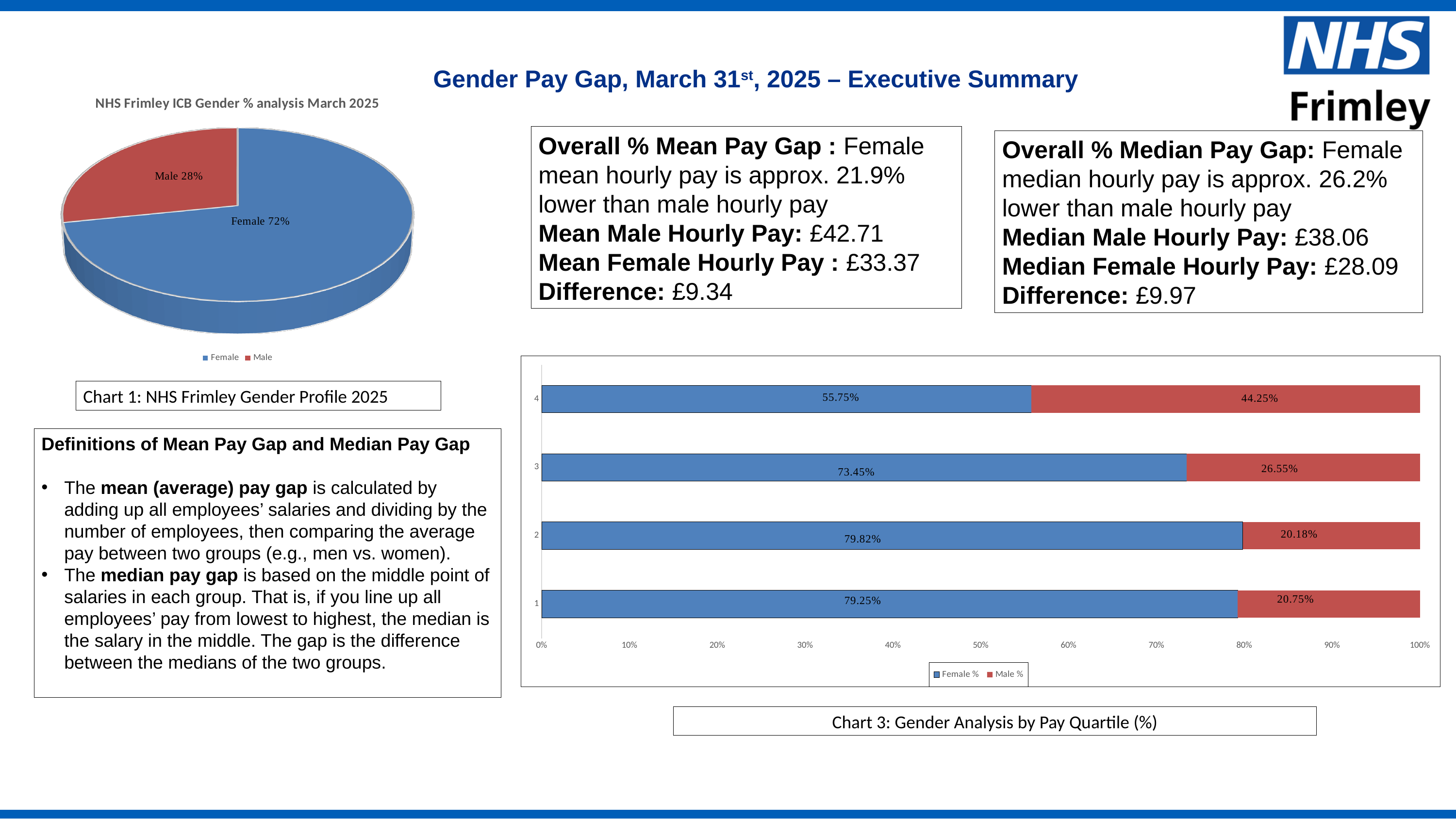
In Chart 3: Gender Analysis by Pay Quartile (%), which quartile has the highest Male %? 4 In the pie chart titled 'NHS Frimley ICB Gender % analysis March 2025', what share is Male? 28% In Chart 3: Gender Analysis by Pay Quartile (%), what is the Female % value for quartile 4? 55.75% In Chart 3: Gender Analysis by Pay Quartile (%), what is the difference between the Female % and Male % values for quartile 1? 58.50% What kind of chart is the chart titled 'NHS Frimley ICB Gender % analysis March 2025'? Pie chart In Chart 3: Gender Analysis by Pay Quartile (%), how many series does the legend list? 2 What kind of chart is Chart 3: Gender Analysis by Pay Quartile (%)? Stacked bar chart In Chart 3: Gender Analysis by Pay Quartile (%), what is the Male % value for quartile 3? 26.55% In the pie chart titled 'NHS Frimley ICB Gender % analysis March 2025', how many slices are there? 2 In Chart 3: Gender Analysis by Pay Quartile (%), which quartile has the highest Female %? 2 In the pie chart titled 'NHS Frimley ICB Gender % analysis March 2025', what share is Female? 72% In the pie chart titled 'NHS Frimley ICB Gender % analysis March 2025', which slice is larger, Female or Male? Female